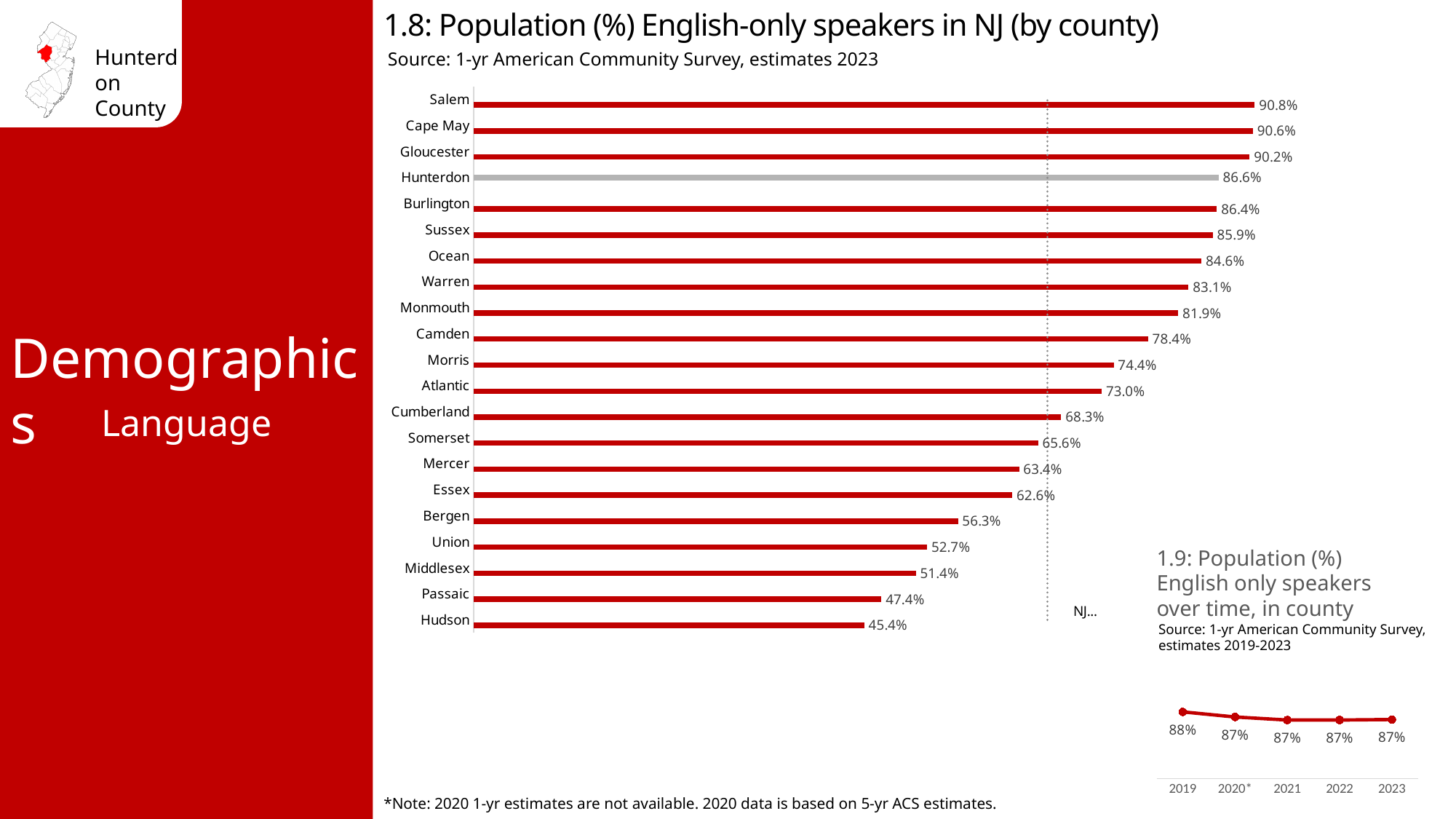
In chart 1.8, which has a larger value, Morris or Camden? Camden In chart 1.8, what is the difference between the values for Hunterdon and Burlington? 0.2% In chart 1.9, do the values rise or fall from 2019 to 2023? fall What kind of chart is chart 1.8? bar chart In chart 1.8, which county has the lowest percentage of English-only speakers? Hudson In chart 1.8, what is the difference between the values for Salem and Hudson? 45.4% In chart 1.8, what is the value for Hunterdon? 86.6% In chart 1.8, how many counties are shown? 21 In chart 1.8, what is the value for Hudson? 45.4% In chart 1.8, which county has the highest percentage of English-only speakers? Salem In chart 1.9, what is the value for 2019? 88% In chart 1.9, how many years are plotted? 5